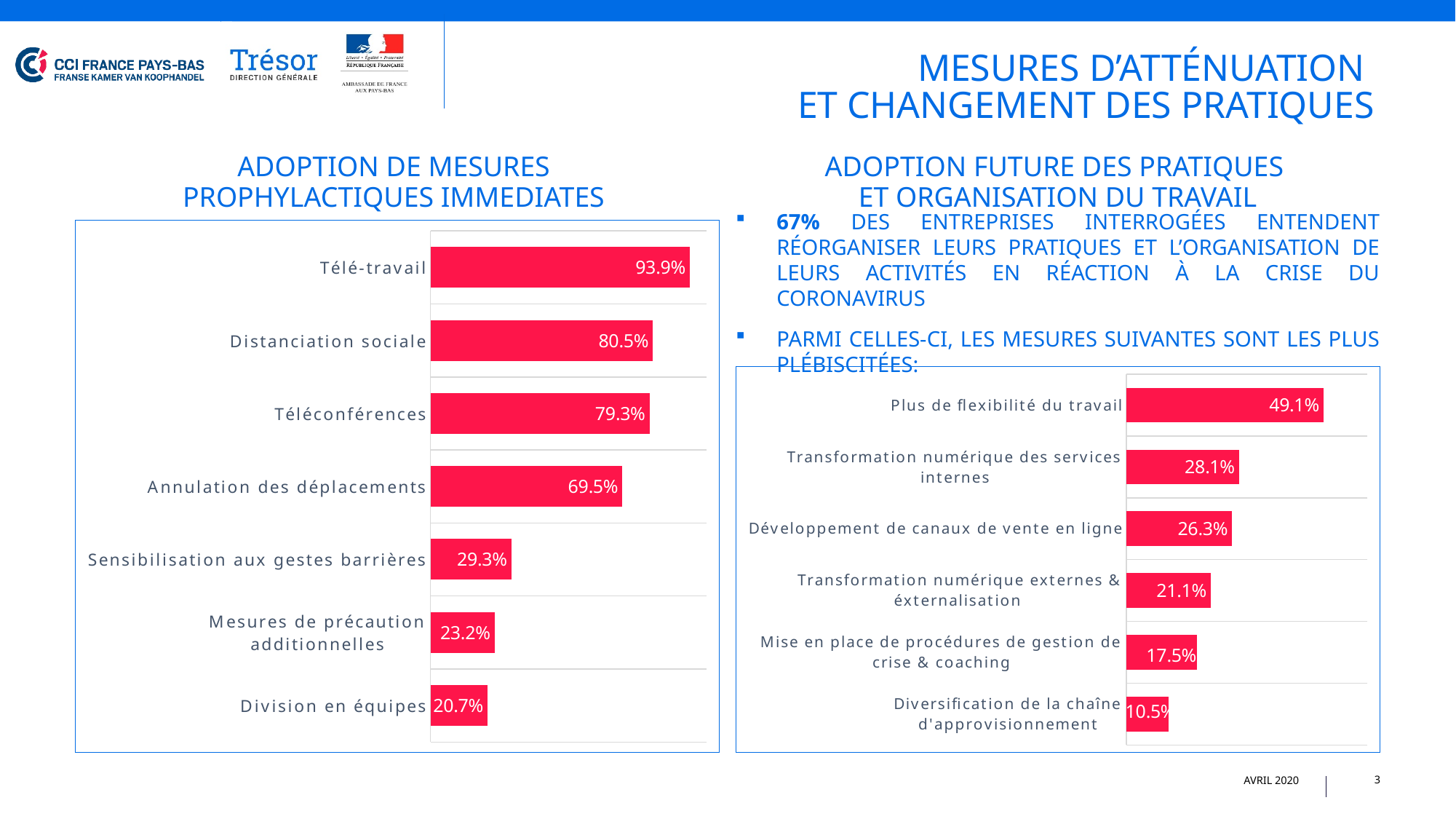
In the right chart (Adoption future des pratiques et organisation du travail), which category has the highest value? Plus de flexibilité du travail In the right chart (Adoption future des pratiques et organisation du travail), what is the difference between Transformation numérique des services internes and Développement de canaux de vente en ligne? 1.8% In the right chart (Adoption future des pratiques et organisation du travail), what is the value for Mise en place de procédures de gestion de crise & coaching? 17.5% In the right chart (Adoption future des pratiques et organisation du travail), how many categories are shown? 6 In the right chart (Adoption future des pratiques et organisation du travail), what is the value for Plus de flexibilité du travail? 49.1% In the left chart (Adoption de mesures prophylactiques immediates), what is the difference between Télé-travail and Distanciation sociale? 13.4% In the left chart (Adoption de mesures prophylactiques immediates), which is larger: Sensibilisation aux gestes barrières or Mesures de précaution additionnelles? Sensibilisation aux gestes barrières What type of chart is the left chart (Adoption de mesures prophylactiques immediates)? Bar chart In the left chart (Adoption de mesures prophylactiques immediates), what is the value for Annulation des déplacements? 69.5% In the left chart (Adoption de mesures prophylactiques immediates), how many categories are shown? 7 In the left chart (Adoption de mesures prophylactiques immediates), what is the value for Télé-travail? 93.9% In the left chart (Adoption de mesures prophylactiques immediates), which category has the lowest value? Division en équipes